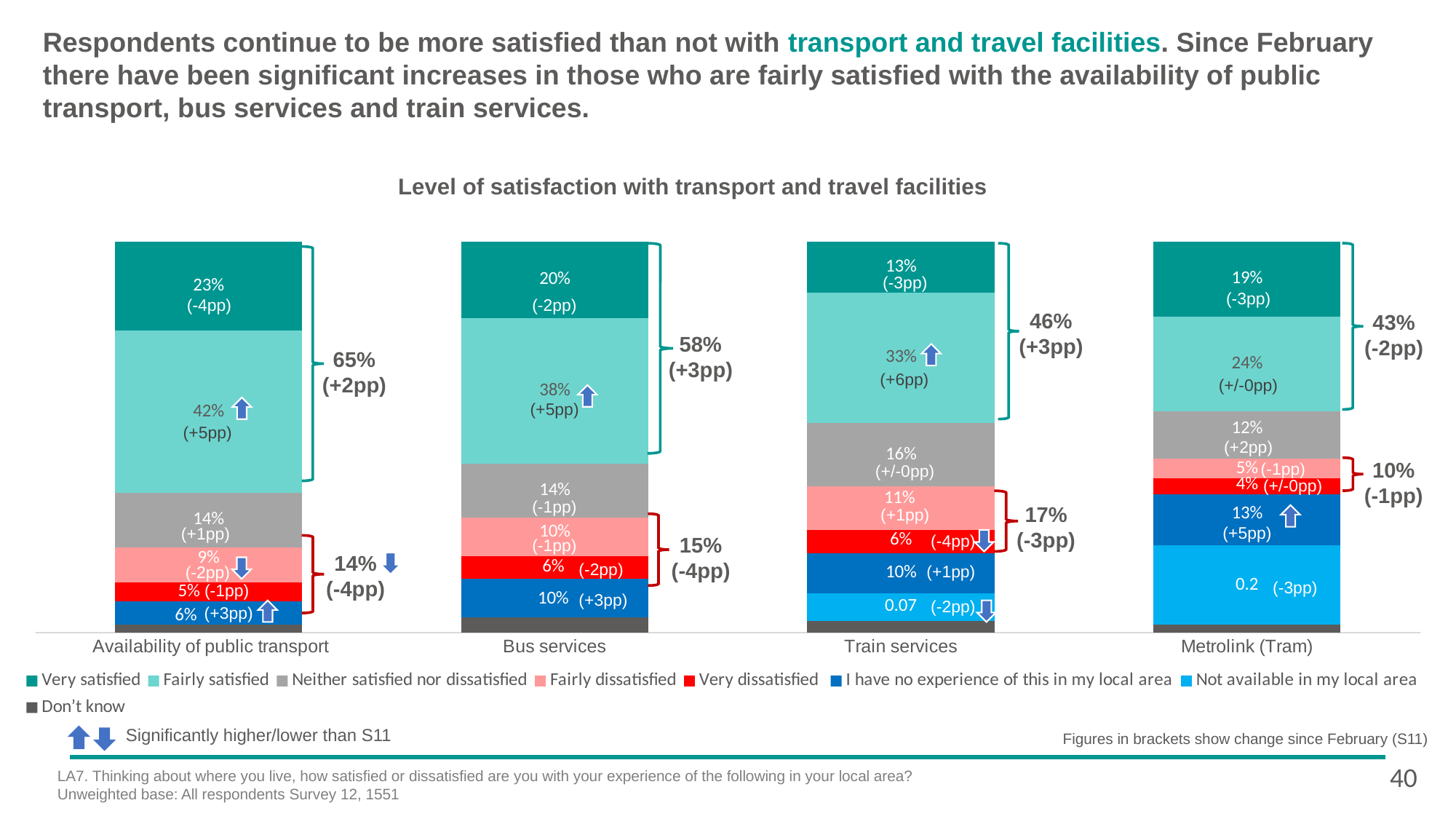
What is the title of the chart? Level of satisfaction with transport and travel facilities What kind of chart is shown on the slide? Stacked bar chart Which is larger: the fairly satisfied percentage for train services or for Metrolink (Tram)? Train services Which category has the highest combined satisfied percentage? Availability of public transport What is the combined satisfied (very + fairly) percentage shown for train services? 46% Which category has the lowest combined dissatisfied percentage? Metrolink (Tram) How many categories are shown along the x axis of the chart? 4 What is the difference between the very satisfied percentage for availability of public transport and for train services? 10 percentage points How many series does the chart legend list? 8 What percentage of respondents are very satisfied with Metrolink (Tram)? 19% What is the change since February shown for the fairly satisfied share of train services? +6pp What percentage of respondents are fairly satisfied with bus services? 38%